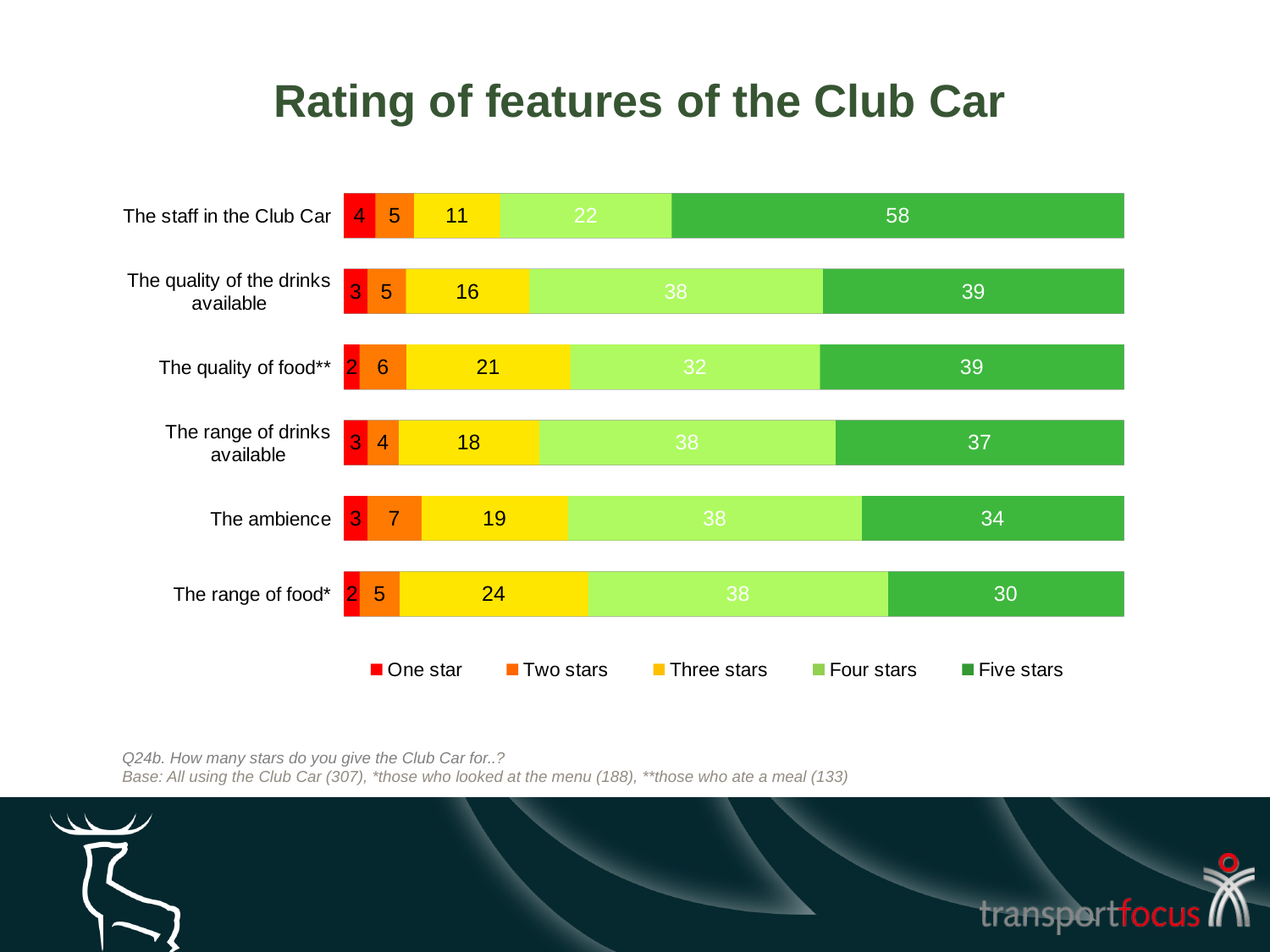
What is the Four stars value for The quality of food**? 32 What is the Three stars value for The range of food*? 24 Which category has the highest Five stars value? The staff in the Club Car What is the Two stars value for The ambience? 7 How many categories are shown in the chart? 6 Which has a larger Three stars value, The quality of food** or The quality of the drinks available? The quality of food** What is the total of the stacked bar for The range of drinks available? 100 What is the difference between the Five stars values for The staff in the Club Car and The ambience? 24 Which category has the lowest Five stars value? The range of food* What kind of chart is shown on the slide? Stacked bar chart How many series does the legend list? 5 What is the Five stars value for The staff in the Club Car? 58